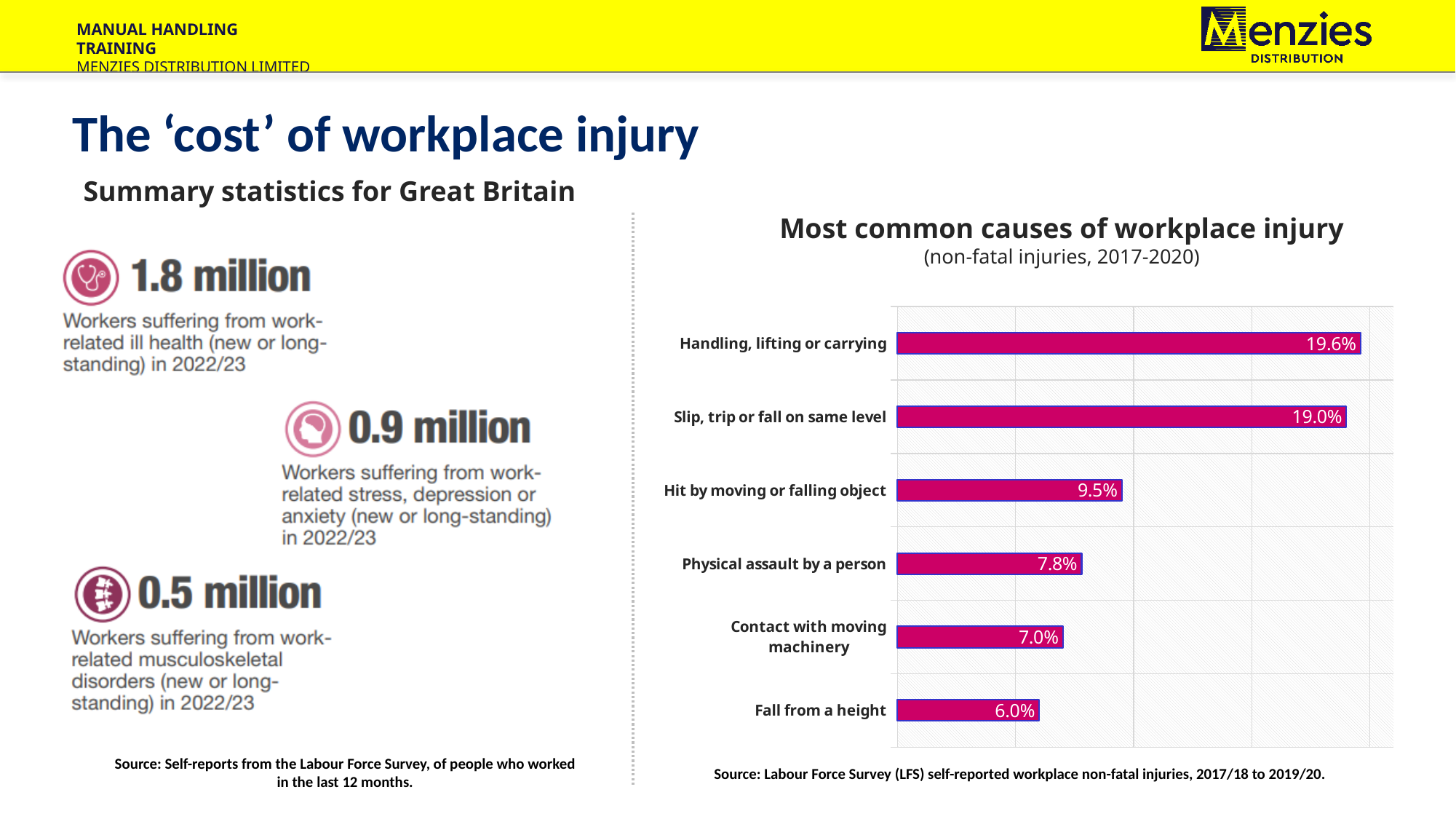
Which cause of workplace injury has the highest value? Handling, lifting or carrying What is the difference between the values for Handling, lifting or carrying and Slip, trip or fall on same level? 0.6% What is the value for Hit by moving or falling object? 9.5% What kind of chart is used to show the most common causes of workplace injury? Bar chart What is the value for Fall from a height? 6.0% What is the value for Physical assault by a person? 7.8% Which cause of workplace injury has the lowest value? Fall from a height What is the value for Slip, trip or fall on same level? 19.0% What is the value for Handling, lifting or carrying? 19.6% How many causes of workplace injury are shown in the chart? 6 Which is larger, the value for Hit by moving or falling object or the value for Physical assault by a person? Hit by moving or falling object What is the value for Contact with moving machinery? 7.0%